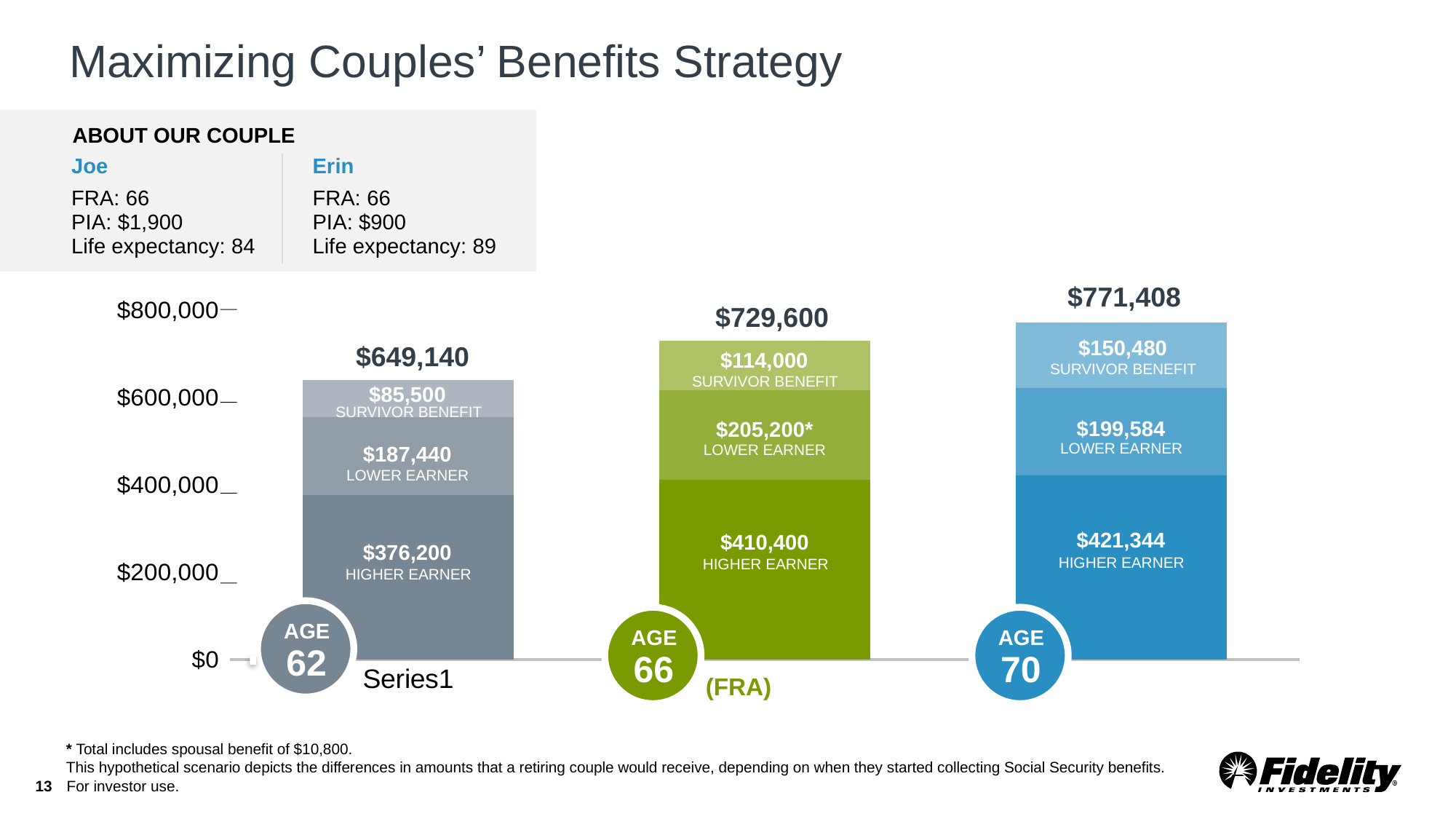
What is the difference between the total benefit at Age 70 and at Age 62? $122,268 What kind of chart is shown on the slide? Stacked bar chart Which claiming age has the highest total benefit? Age 70 How many bars are plotted in the chart? 3 What is the Survivor Benefit amount in the Age 70 bar? $150,480 What is the total benefit shown for the Age 62 bar? $649,140 What is the Higher Earner amount in the Age 66 (FRA) bar? $410,400 What is the difference between the Survivor Benefit at Age 70 and at Age 62? $64,980 Which claiming age has the lowest total benefit? Age 62 Is the Higher Earner amount larger at Age 66 or at Age 70? Age 70 What is the Lower Earner amount in the Age 62 bar? $187,440 What is the total benefit shown for the Age 70 bar? $771,408